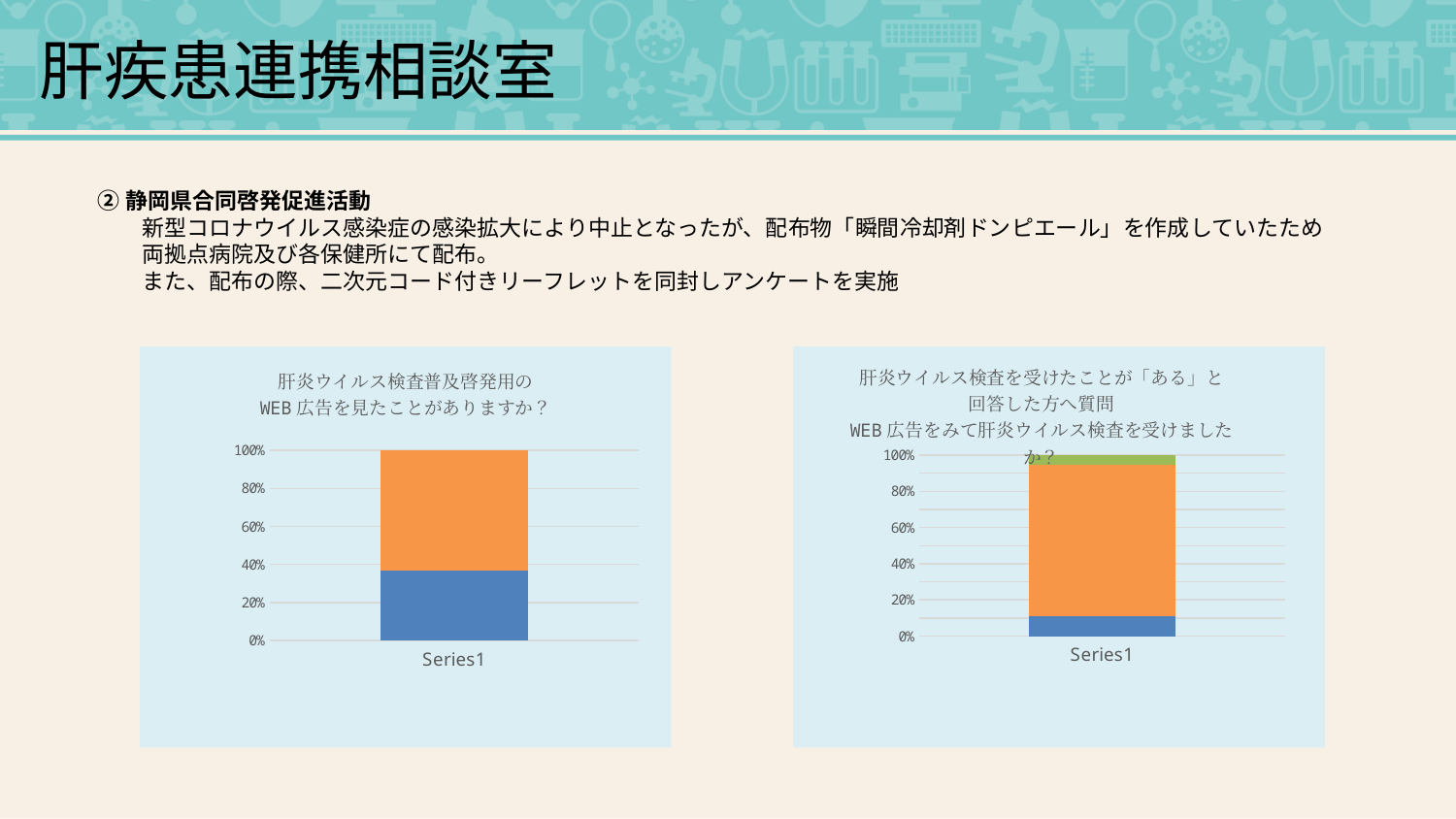
In the left chart, how many categories are shown on the x axis? 1 In the right chart, what is the total height of the stacked bar for Series1? 100% In the right chart, how many coloured segments make up the bar? 3 What kind of chart is the left chart (肝炎ウイルス検査普及啓発用のWEB広告を見たことがありますか？)? Stacked bar chart In the right chart, which coloured segment is the smallest? Green In the left chart, is the top of the blue segment greater or less than 20%? greater In the left chart, which segment is larger, the blue one or the orange one? Orange What kind of chart is the right chart (WEB広告をみて肝炎ウイルス検査を受けましたか？)? Stacked bar chart In the right chart, is the top of the blue segment greater or less than 20%? less In the left chart, is the top of the blue segment greater or less than 40%? less In the left chart, what is the total height of the stacked bar for Series1? 100% In the left chart, how many coloured segments make up the bar? 2